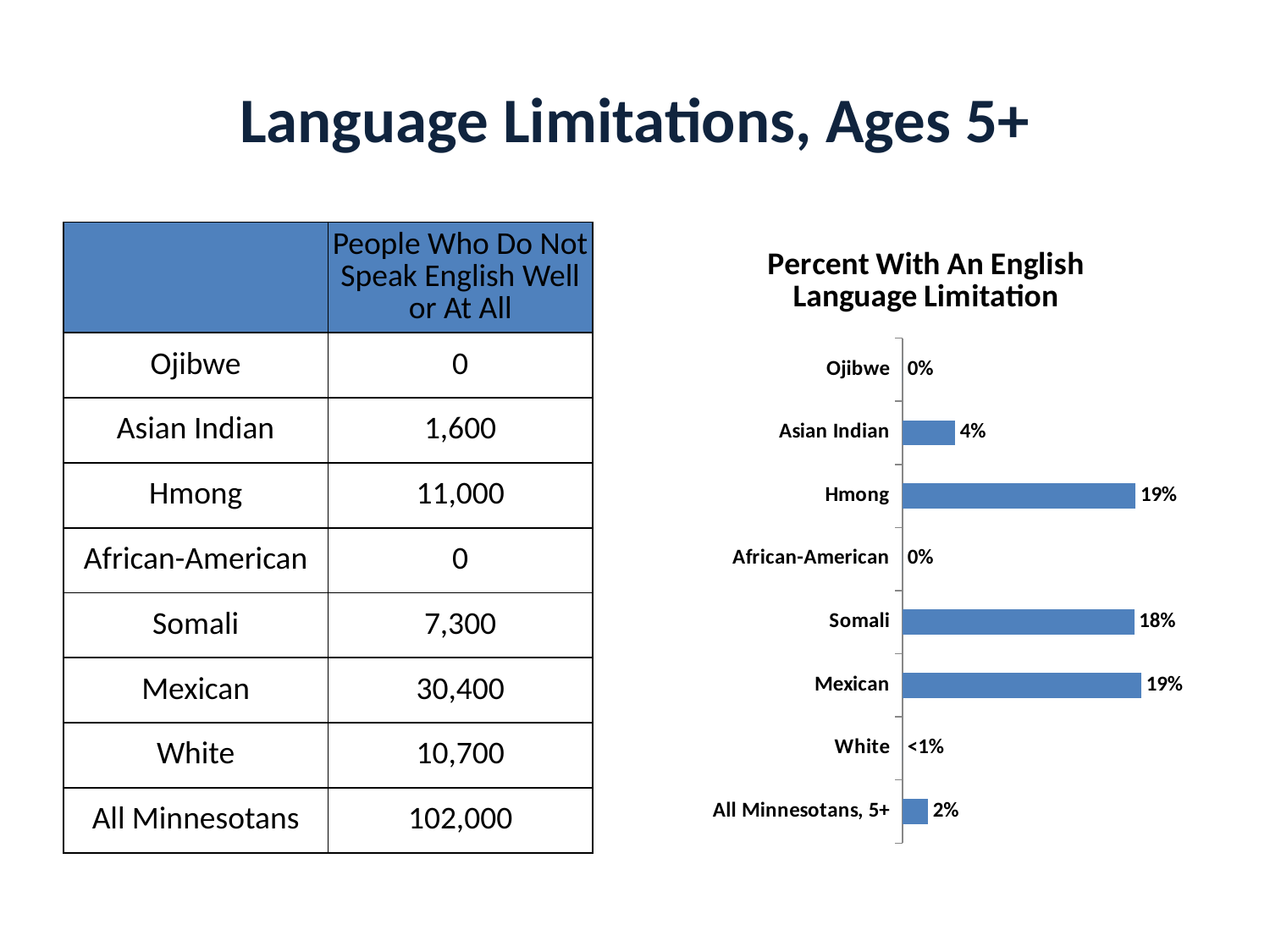
What is the value for All Minnesotans, 5+ in the chart? 2% What is the value for Hmong in the chart? 19% What is the difference between the values for Somali and All Minnesotans, 5+? 16% What is the value for Somali in the chart? 18% What is the title of the chart? Percent With An English Language Limitation What is the value for Asian Indian in the chart? 4% What is the difference between the values for Hmong and Asian Indian? 15% Which has the larger value, Somali or Asian Indian? Somali What is the value for African-American in the chart? 0% How many categories are shown in the chart? 8 What is the value shown for White in the chart? <1% What kind of chart is shown on the slide? Bar chart